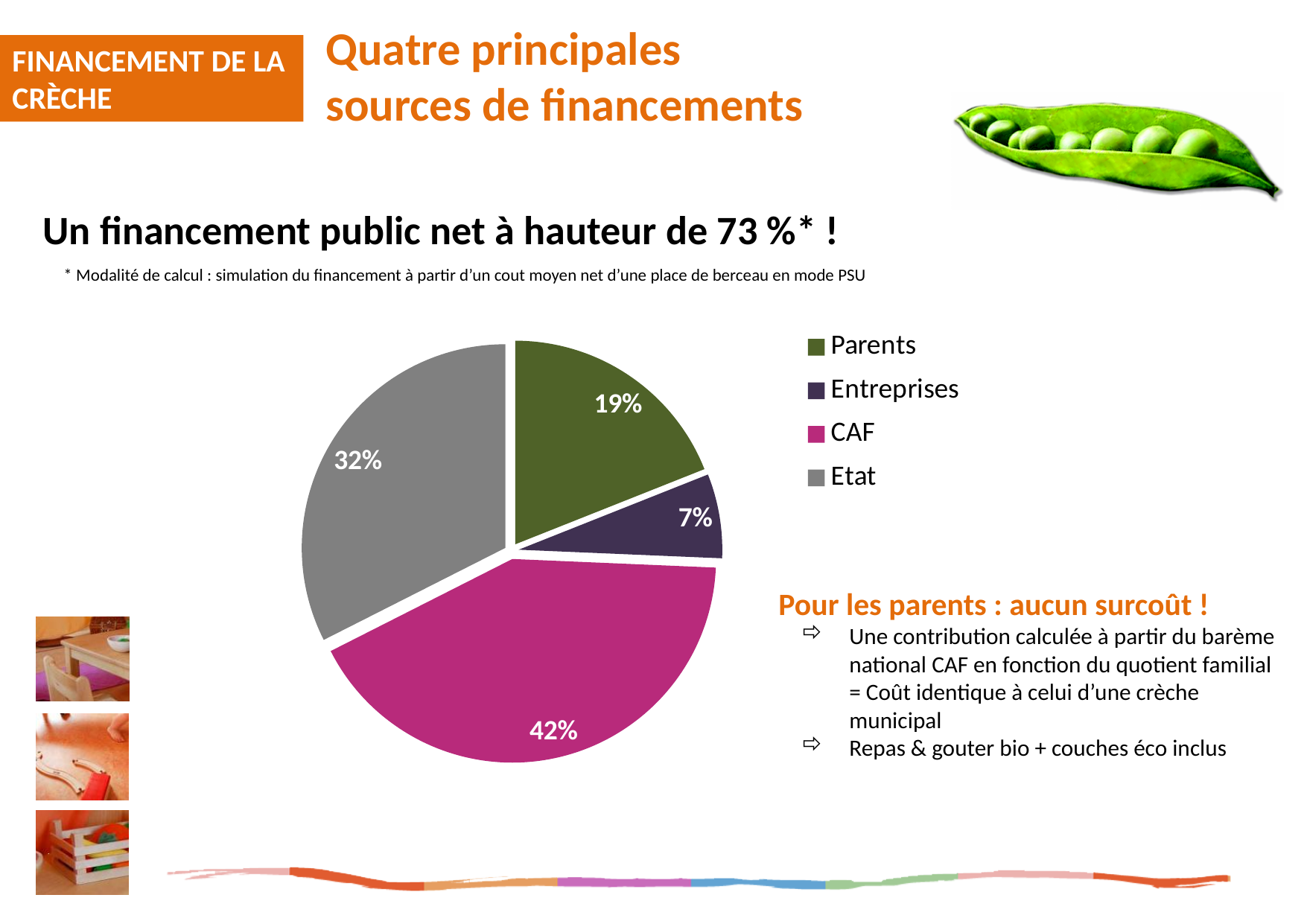
Which category has the largest slice of the pie? CAF What colour is the CAF slice in the pie chart? magenta Which category has the smallest slice of the pie? Entreprises What share of the pie does Etat represent? 32% How many entries does the legend list? 4 What share of the pie does Parents represent? 19% What is the difference in percentage points between the CAF slice and the Etat slice? 10 How many slices does the pie chart have? 4 What share of the pie does Entreprises represent? 7% What share of the pie does CAF represent? 42% What kind of chart is shown on the slide? pie chart Which is larger, the Parents slice or the Etat slice? Etat